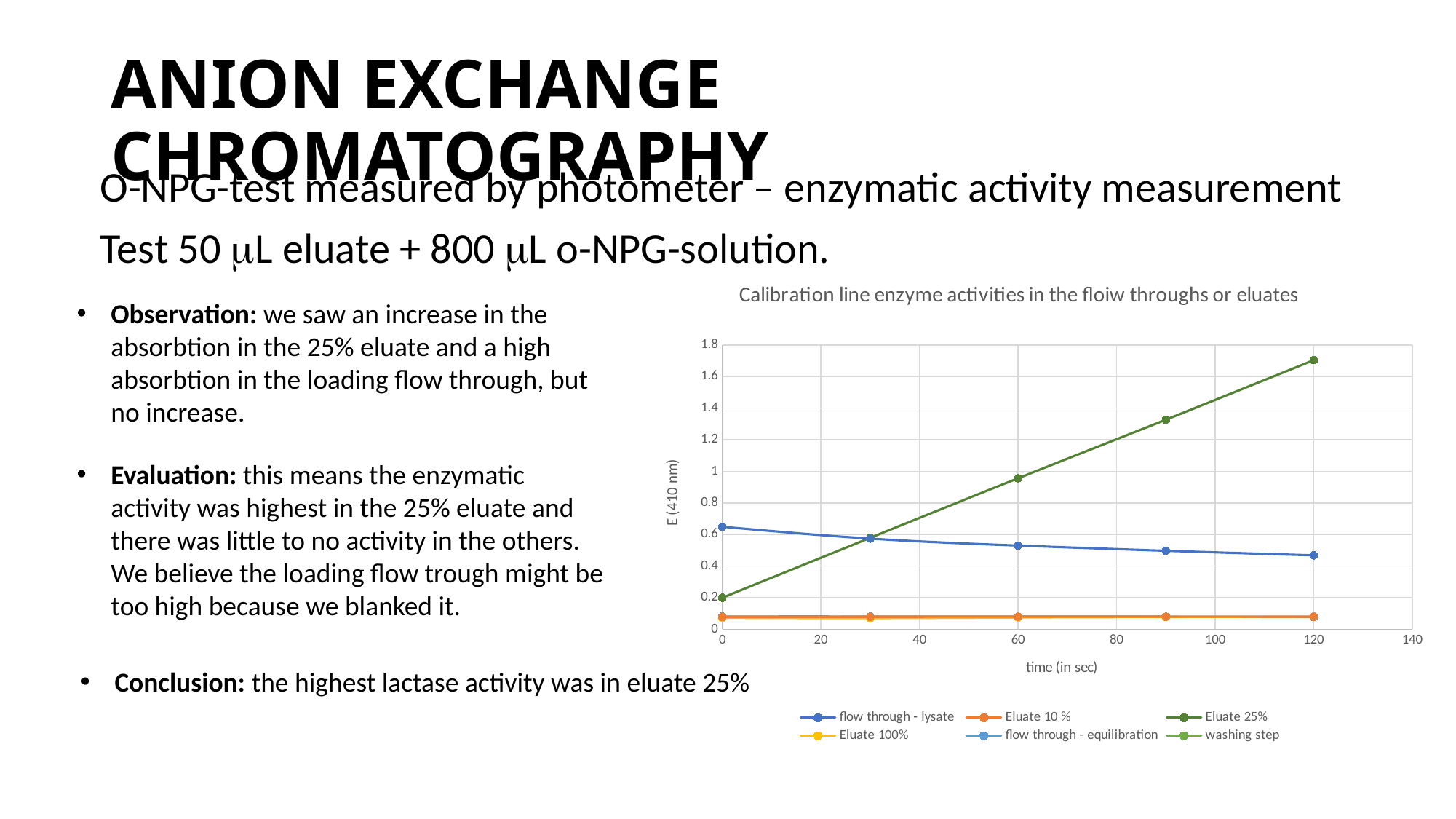
Is the value for Eluate 10 % at 120 sec greater or less than 0.2? less At 0 sec, which is larger: flow through - lysate or Eluate 25%? flow through - lysate Which series has the highest value at 120 sec? Eluate 25% What kind of chart is shown on the slide? line chart What is the label of the y axis of the chart? E (410 nm) What is the title of the chart? Calibration line enzyme activities in the floiw throughs or eluates Does the value for flow through - lysate rise or fall as time increases? fall Does the value for Eluate 25% rise or fall as time increases? rise How many data points are plotted for the Eluate 25% series? 5 Is the value for Eluate 25% at 120 sec greater or less than 1.4? greater At 120 sec, which is larger: Eluate 25% or flow through - lysate? Eluate 25% How many series does the chart legend list? 6